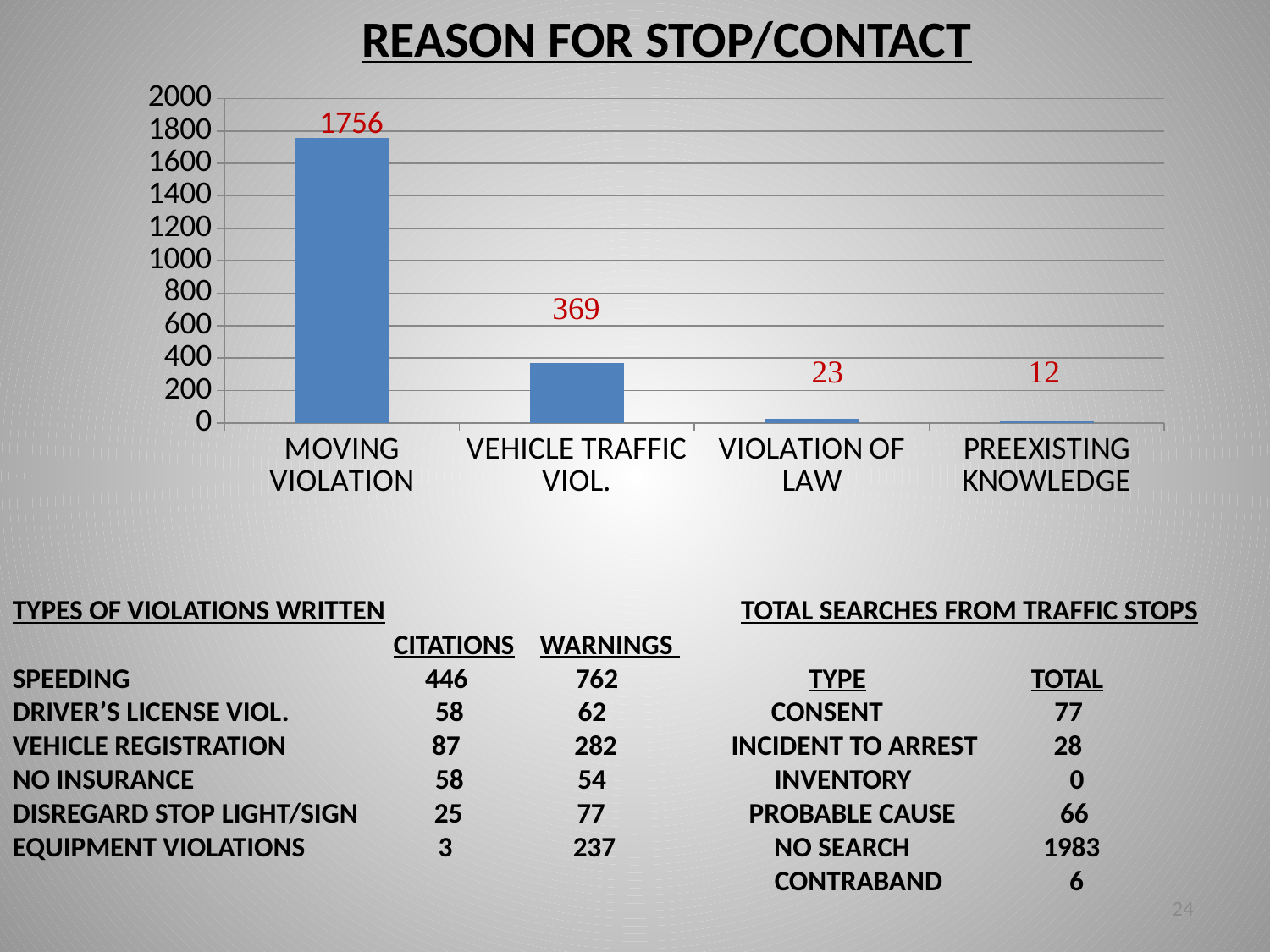
Which category has the lowest value? PREEXISTING KNOWLEDGE What is the difference between the values for MOVING VIOLATION and VEHICLE TRAFFIC VIOL.? 1387 Is the value for VEHICLE TRAFFIC VIOL. greater or less than 400? less Which category has the highest value? MOVING VIOLATION How many categories are shown on the x axis? 4 Which is larger, the value for VIOLATION OF LAW or the value for PREEXISTING KNOWLEDGE? VIOLATION OF LAW What is the title of the chart? REASON FOR STOP/CONTACT What kind of chart is shown? bar chart What is the value for VIOLATION OF LAW? 23 What is the value for PREEXISTING KNOWLEDGE? 12 What is the value for VEHICLE TRAFFIC VIOL.? 369 What is the value for MOVING VIOLATION? 1756